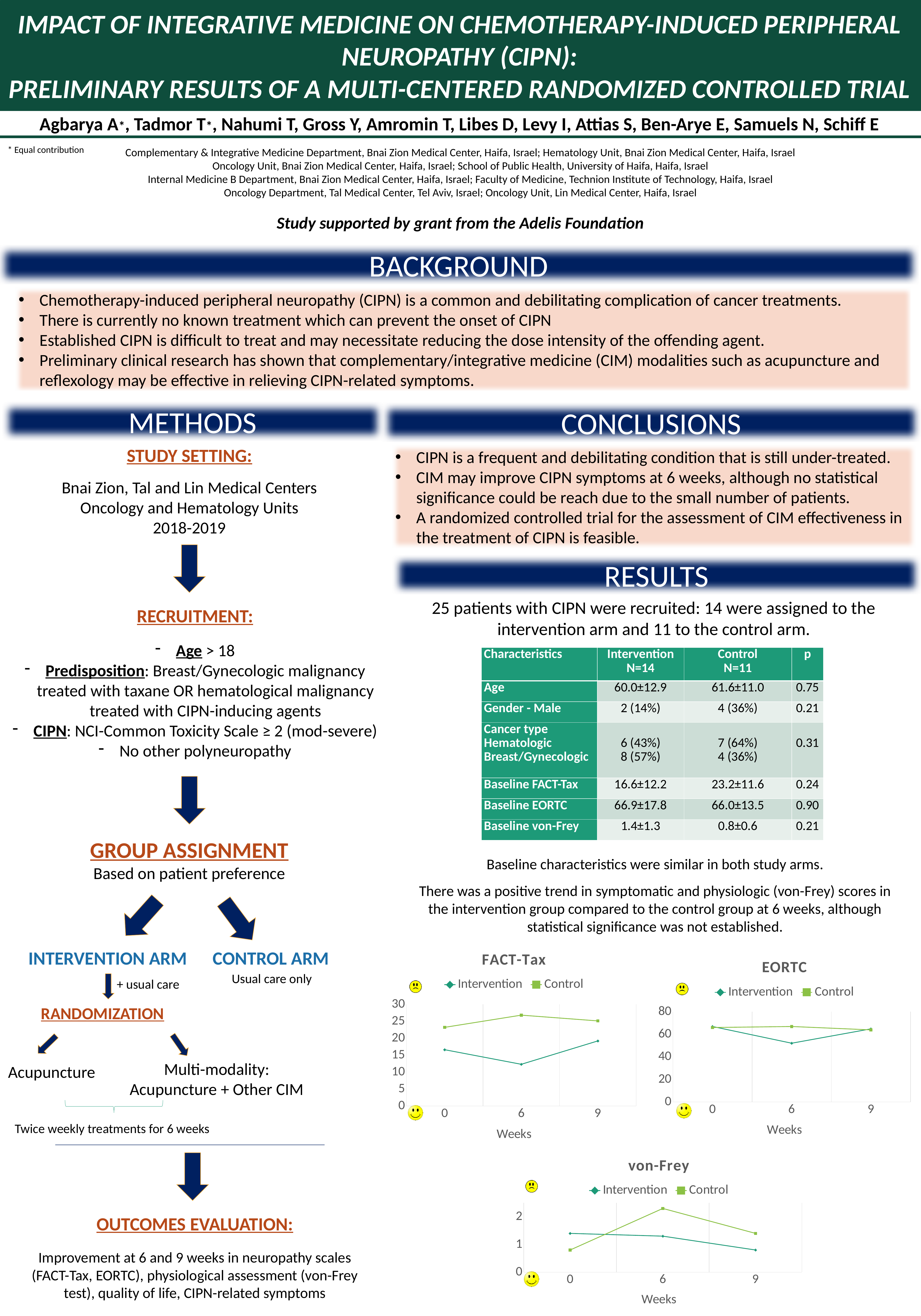
In the EORTC chart, which series has the larger value at week 6, Intervention or Control? Control How many series does the legend of the EORTC chart list? 2 In the von-Frey chart, is the Control value at week 6 greater or less than 2? greater What is the x-axis label on the von-Frey chart? Weeks In the FACT-Tax chart, does the Intervention series rise or fall from week 0 to week 6? fall In the FACT-Tax chart, which series has the larger value at week 0, Intervention or Control? Control In the FACT-Tax chart, is the Intervention value at week 6 greater or less than 15? less In the FACT-Tax chart, is the Control value at week 6 greater or less than 20? greater What kind of chart is the FACT-Tax chart? line chart In the von-Frey chart, which series has the larger value at week 0, Intervention or Control? Intervention How many time points are plotted along the x axis of the von-Frey chart? 3